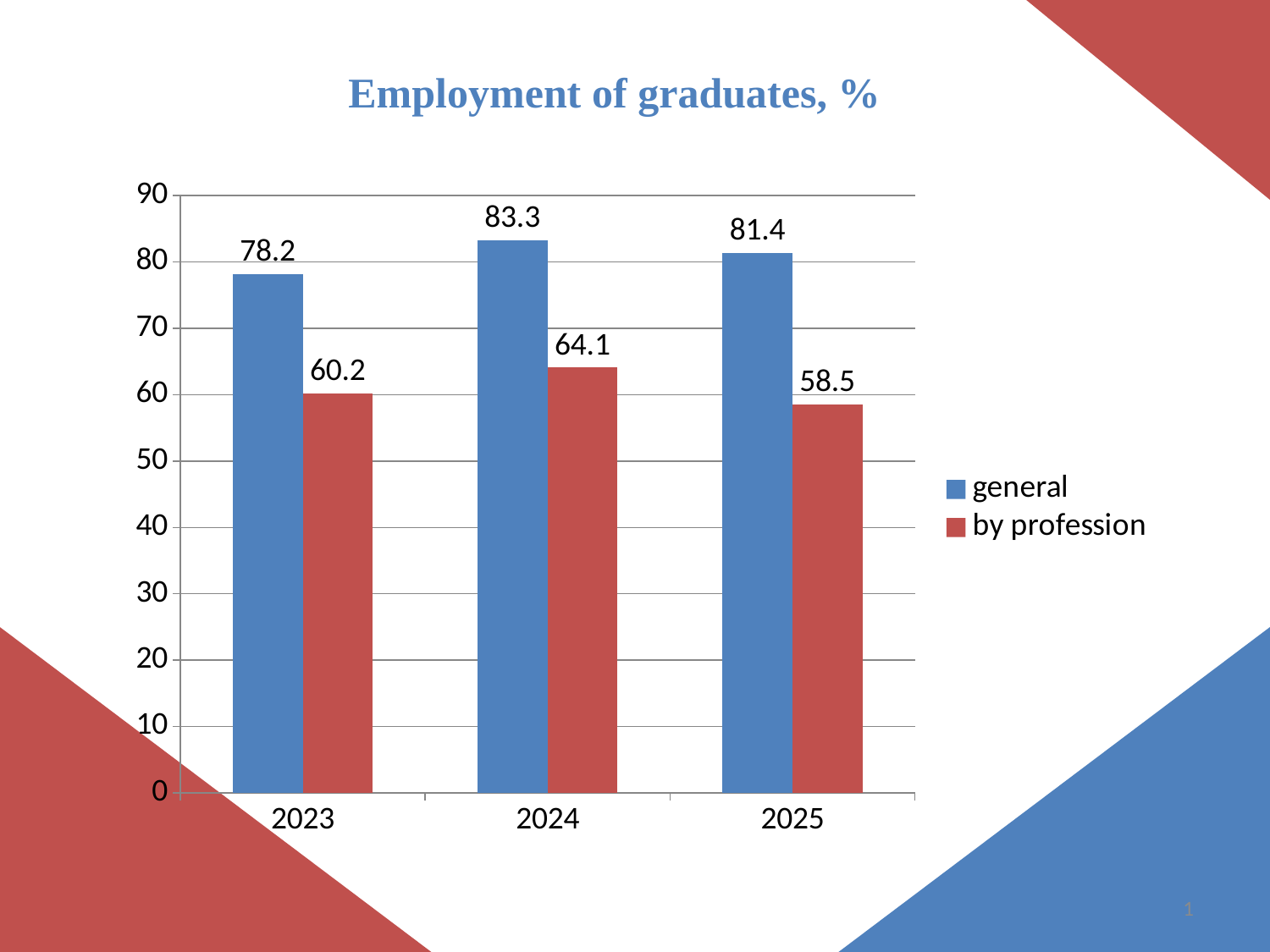
What kind of chart is shown on the slide? bar chart How many years are shown on the x axis? 3 In which year is the "by profession" value lowest? 2025 Is the "by profession" value for 2024 greater or less than 60? greater What is the value for "general" in 2024? 83.3 In which year is the "general" value highest? 2024 What is the value for "by profession" in 2023? 60.2 Which is larger: the "general" value in 2025 or the "general" value in 2023? 2025 What is the difference between the "general" and "by profession" values in 2023? 18 How many series does the legend list? 2 What is the title of the chart? Employment of graduates, % What is the value for "by profession" in 2025? 58.5